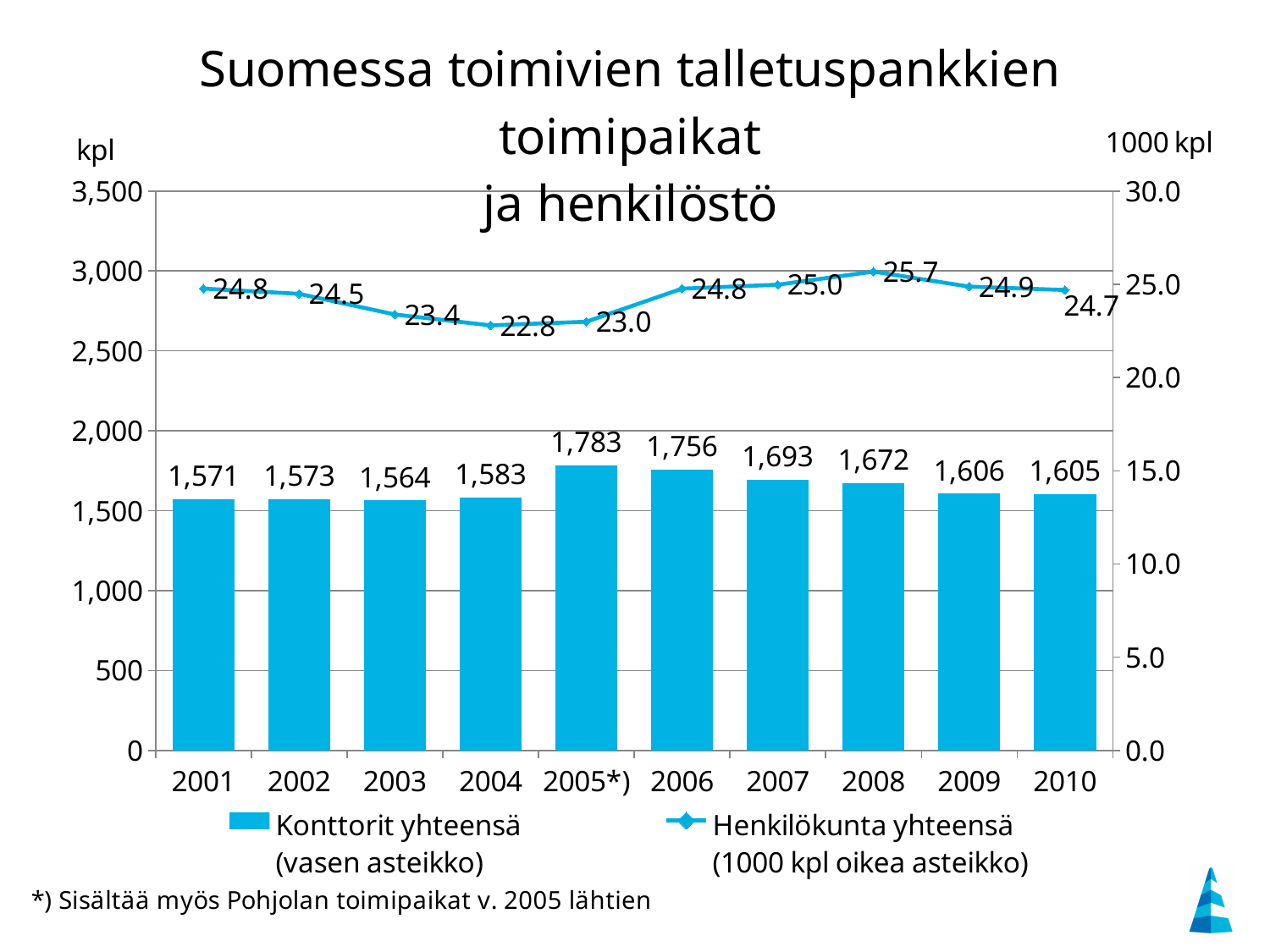
What is the difference between Henkilökunta yhteensä in 2008 and 2004? 2.9 Which year has a larger Konttorit yhteensä value, 2006 or 2007? 2006 Which series is plotted on the right axis (oikea asteikko)? Henkilökunta yhteensä In which year is Henkilökunta yhteensä lowest? 2004 Do the Konttorit yhteensä values rise or fall from 2005*) to 2010? fall What is the difference between Konttorit yhteensä in 2005*) and 2004? 200 What is the value of Konttorit yhteensä for 2010? 1,605 How many series does the legend list? 2 What is the value of Henkilökunta yhteensä for 2008? 25.7 How many years are shown on the x axis? 10 What is the value of Konttorit yhteensä for 2005*)? 1,783 In which year is Konttorit yhteensä highest? 2005*)